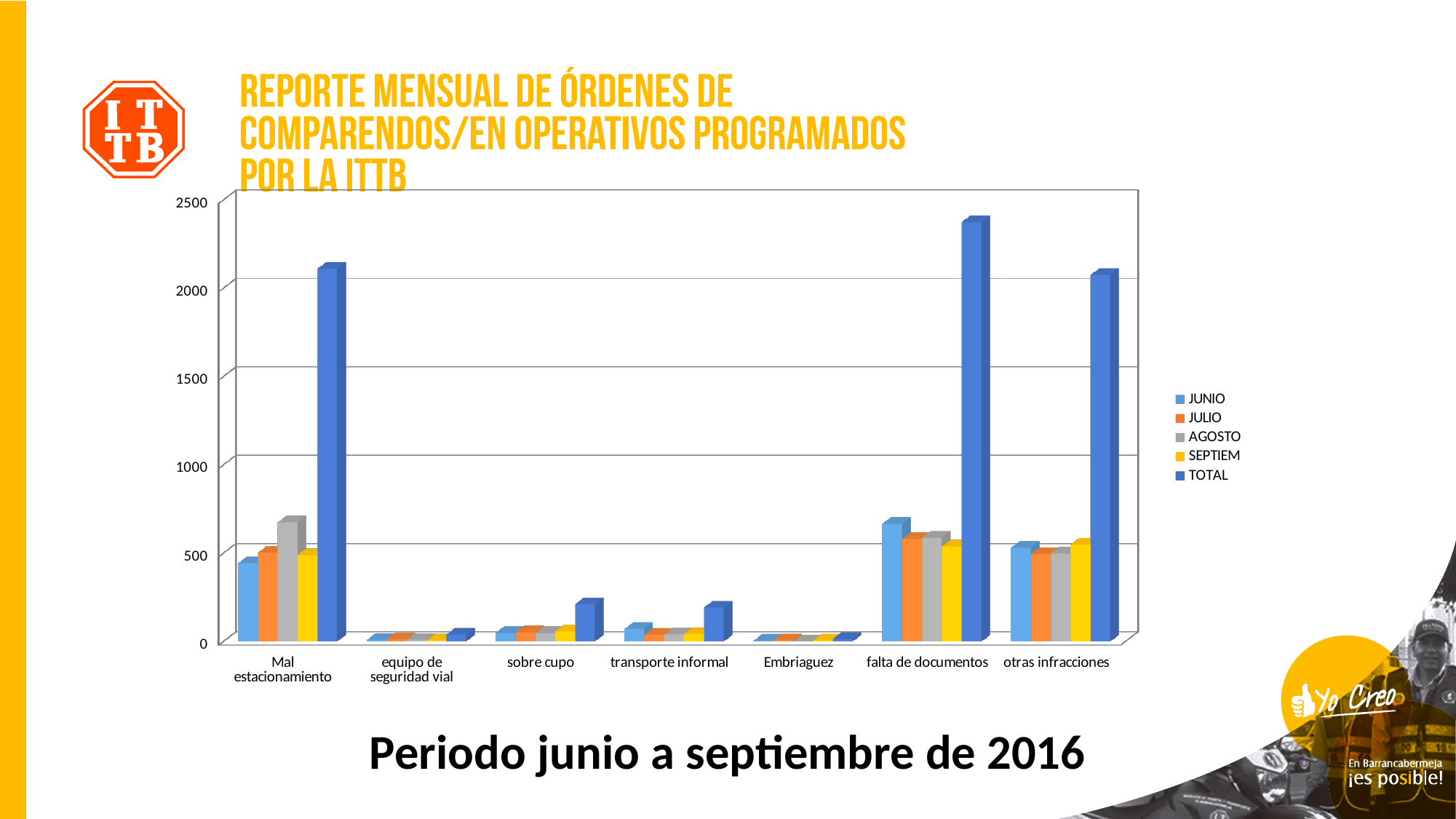
Which is larger, the TOTAL for falta de documentos or the TOTAL for Mal estacionamiento? falta de documentos Is the TOTAL value for otras infracciones greater or less than 1500? greater Is the TOTAL value for Mal estacionamiento greater or less than 2000? greater How many categories are shown on the x axis of the chart? 7 What kind of chart is shown on the slide? bar chart Is the AGOSTO value for Mal estacionamiento greater or less than 500? greater How many series does the chart legend list? 5 Which is larger, the JUNIO value for falta de documentos or the JUNIO value for Embriaguez? falta de documentos Which series is shown in dark blue in the chart legend? TOTAL Which category has the highest TOTAL bar? falta de documentos